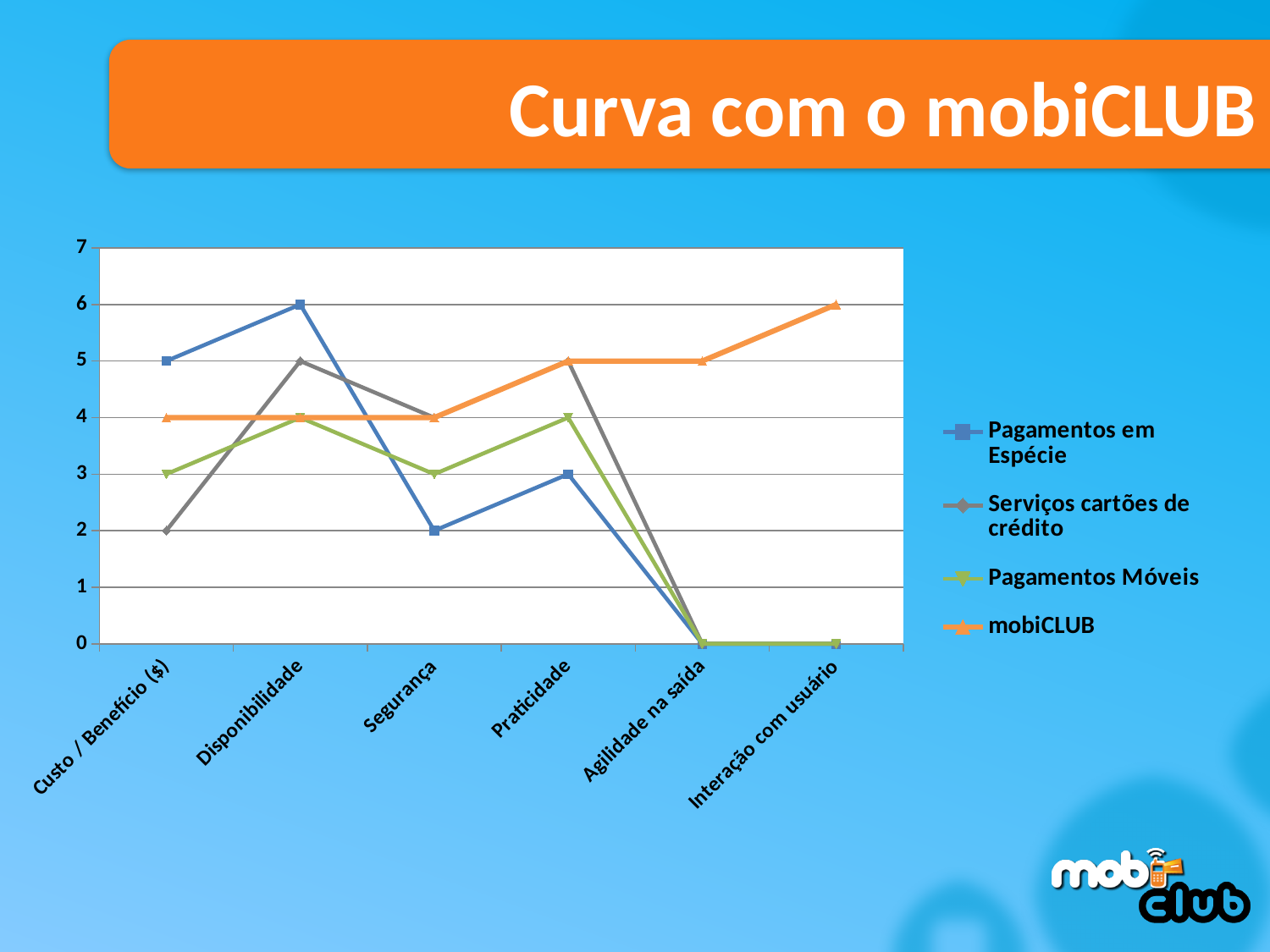
What is the value for mobiCLUB at Interação com usuário? 6 What is the title of the slide containing the chart? Curva com o mobiCLUB Which series has the lowest value at Custo / Benefício ($)? Serviços cartões de crédito How many series does the legend list? 4 What is the value for Pagamentos em Espécie at Disponibilidade? 6 Which is larger at Praticidade: Pagamentos em Espécie or Pagamentos Móveis? Pagamentos Móveis What is the value for Serviços cartões de crédito at Custo / Benefício ($)? 2 What is the value for Pagamentos Móveis at Segurança? 3 Which series has the highest value at Agilidade na saída? mobiCLUB What is the difference between Pagamentos em Espécie and mobiCLUB at Segurança? 2 What kind of chart is shown on the slide? line chart How many categories are shown on the x axis? 6